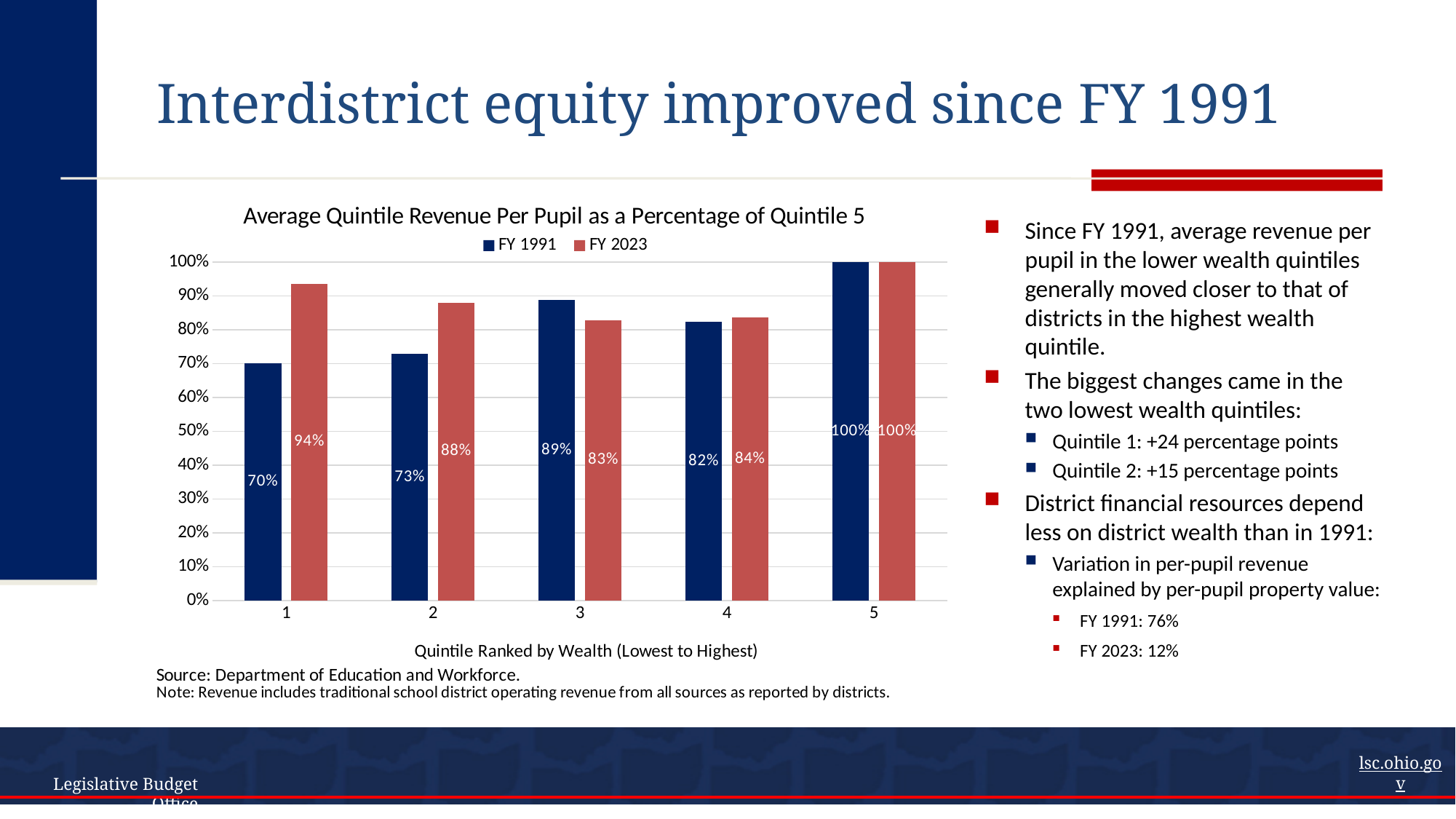
How many quintiles are shown on the x axis? 5 Which quintile has the lowest FY 2023 value? 3 What is the FY 2023 value for quintile 2? 88% Which quintile has the lowest FY 1991 value? 1 What is the FY 2023 value for quintile 4? 84% Which is larger for quintile 3, the FY 1991 value or the FY 2023 value? FY 1991 What is the FY 1991 value for quintile 3? 89% What is the FY 1991 value for quintile 1? 70% What is the title of the chart? Average Quintile Revenue Per Pupil as a Percentage of Quintile 5 What is the difference between the FY 2023 and FY 1991 values for quintile 1? 24 percentage points What kind of chart is shown? Bar chart How many series does the legend list? 2